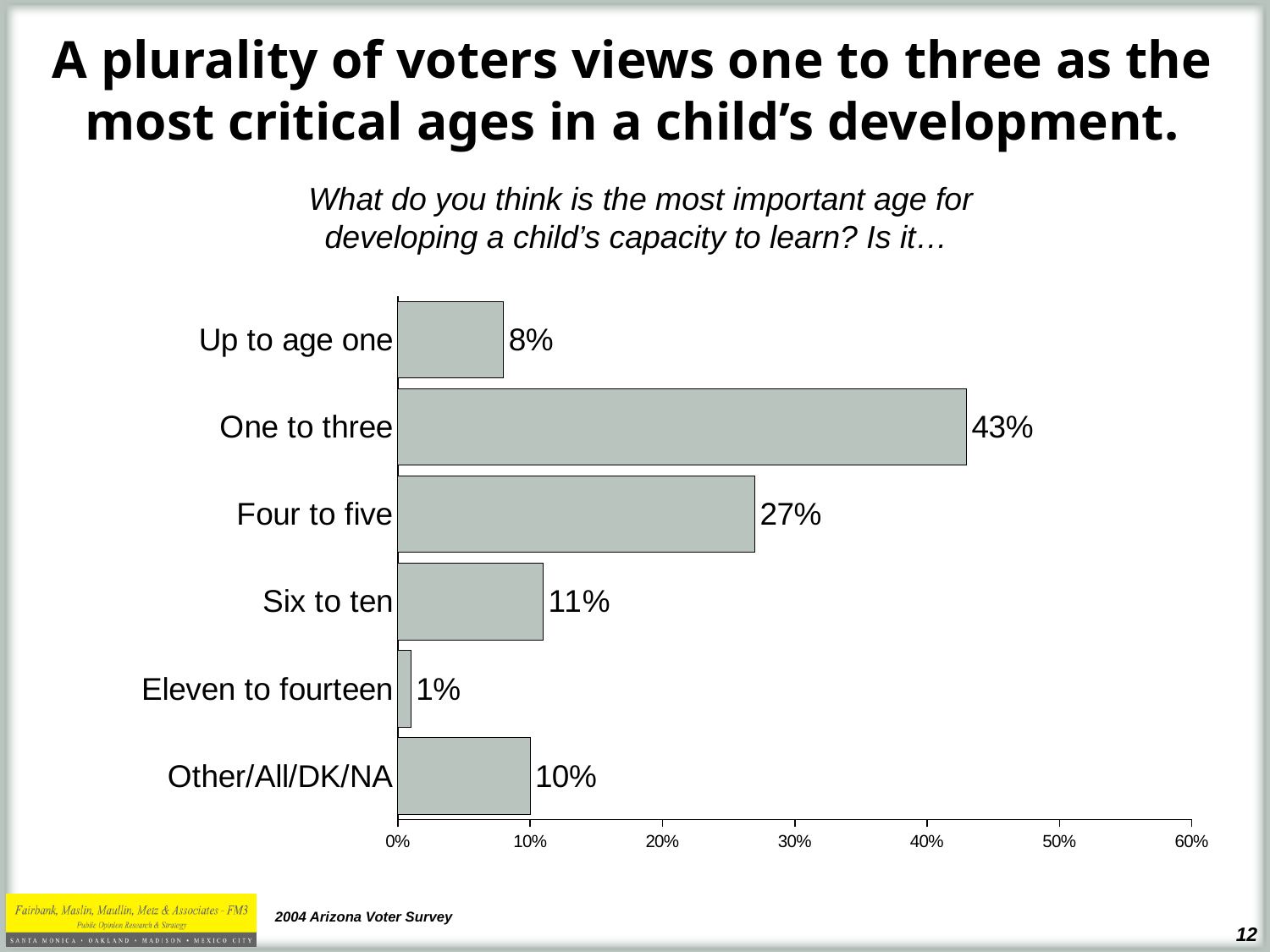
Which is larger, the value for "Six to ten" or the value for "Up to age one"? Six to ten Which category has the lowest percentage? Eleven to fourteen How many categories are shown in the chart? 6 What percentage is shown for "Eleven to fourteen"? 1% What is the value shown for "Four to five"? 27% What kind of chart is shown on the slide? Bar chart What percentage of voters chose "One to three" as the most important age? 43% What is the maximum value shown on the horizontal axis? 60% Is the value for "Four to five" greater or less than 20%? greater Which age range has the highest percentage? One to three What is the difference between the values for "One to three" and "Four to five"? 16% What is the value for "Other/All/DK/NA"? 10%